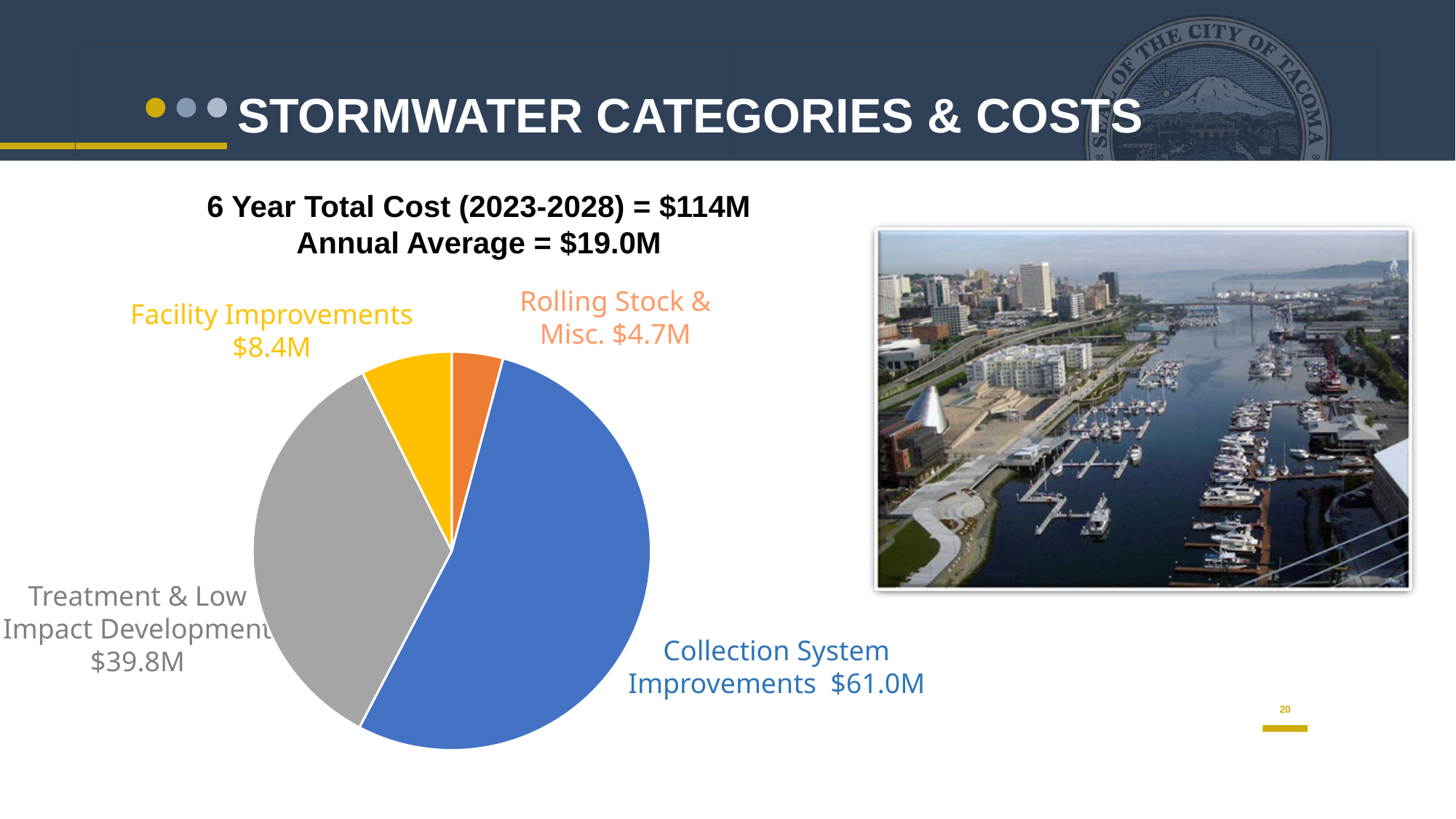
What is the difference between Collection System Improvements and Treatment & Low Impact Development? $21.2M What is the value for Facility Improvements in the pie chart? $8.4M Which is larger, Facility Improvements or Rolling Stock & Misc.? Facility Improvements What is the value for Collection System Improvements in the pie chart? $61.0M How many categories are shown in the pie chart? 4 What is the difference between Facility Improvements and Rolling Stock & Misc.? $3.7M Which category has the smallest slice in the pie chart? Rolling Stock & Misc. Which category has the largest slice in the pie chart? Collection System Improvements What kind of chart is shown on the slide? Pie chart What is the value for Treatment & Low Impact Development in the pie chart? $39.8M What is the value for Rolling Stock & Misc. in the pie chart? $4.7M What 6 year total cost (2023-2028) is stated above the chart? $114M